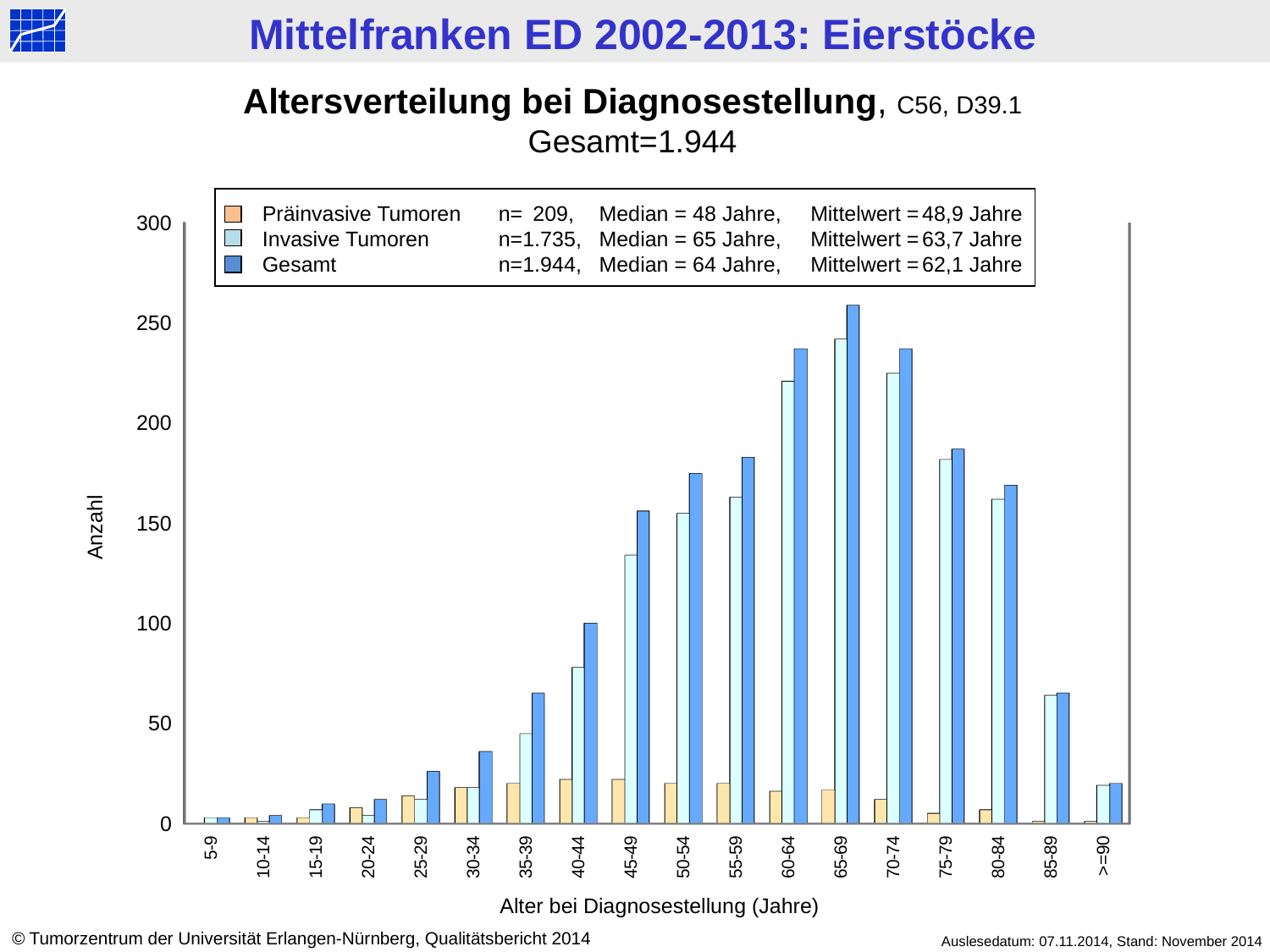
According to the legend, what is the median age for Invasive Tumoren? 65 Jahre Is the Invasive Tumoren value for the 60-64 age group greater or less than 200? greater Which is larger for the Gesamt series: the 45-49 age group or the 35-39 age group? 45-49 Is the Gesamt value for the 85-89 age group greater or less than 50? greater Do the Gesamt values rise or fall from the 5-9 age group to the 65-69 age group? rise How many age groups are shown on the x axis? 18 Is the Invasive Tumoren value for the 75-79 age group greater or less than 200? less What kind of chart is shown on the slide? bar chart Which age group has the highest value for the Invasive Tumoren series? 65-69 Which age group has the highest value for the Gesamt series? 65-69 How many series does the legend list? 3